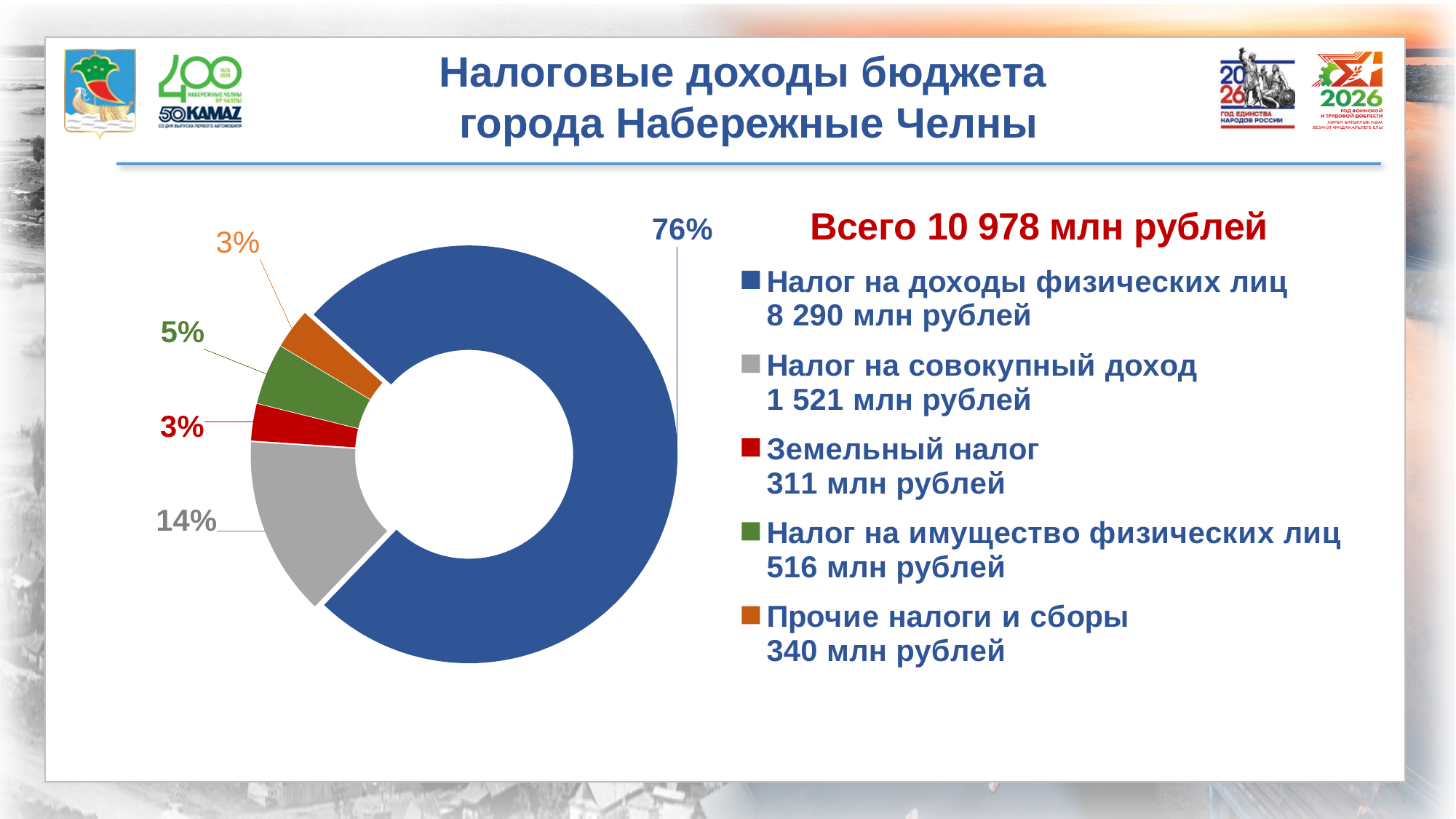
Which category has the smallest value in the legend? Земельный налог What share of the chart does Налог на совокупный доход take? 14% What total amount is stated above the legend? 10 978 млн рублей Which is larger: Налог на имущество физических лиц or Земельный налог? Налог на имущество физических лиц How many categories does the chart have? 5 What share of the chart does Налог на доходы физических лиц take? 76% What is the difference between Налог на доходы физических лиц and Налог на совокупный доход in млн рублей? 6 769 млн рублей What share of the chart does Налог на имущество физических лиц take? 5% What is the value for Земельный налог according to the legend? 311 млн рублей Which category has the largest slice of the chart? Налог на доходы физических лиц What kind of chart is shown on the slide? Pie (donut) chart What is the value for Прочие налоги и сборы according to the legend? 340 млн рублей